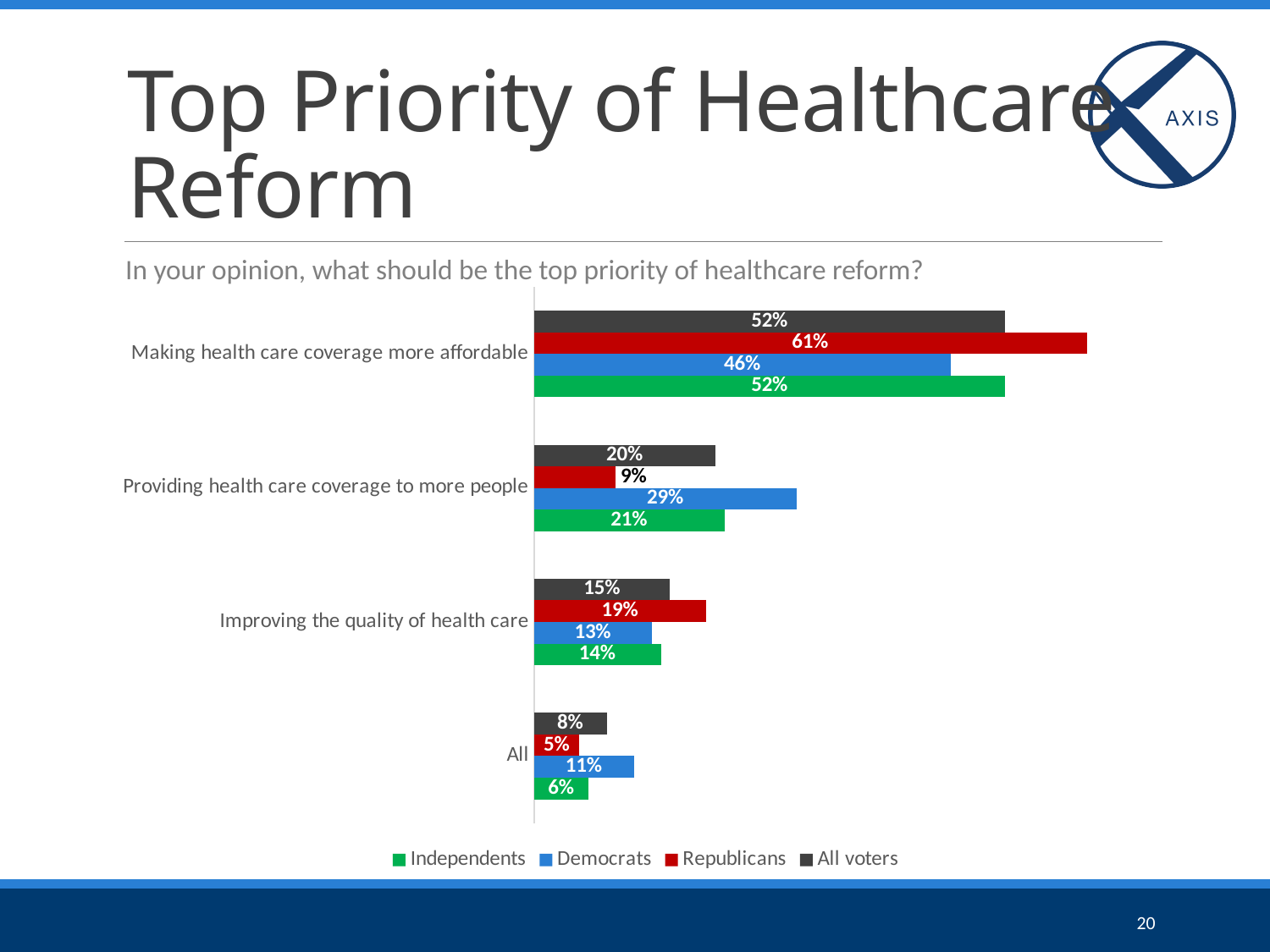
Which group has the lowest value for "Providing health care coverage to more people"? Republicans For "Improving the quality of health care", which is larger: the Republicans value or the Democrats value? Republicans How many priority categories are shown on the chart? 4 What kind of chart is shown on the slide? Bar chart How many series does the legend list? 4 What is the value for Independents for "Improving the quality of health care"? 14% Which group has the highest value for "Making health care coverage more affordable"? Republicans What is the value for Democrats for "Providing health care coverage to more people"? 29% What is the difference between the Republicans and Democrats values for "Making health care coverage more affordable"? 15% What percentage of Republicans chose "Making health care coverage more affordable" as the top priority? 61% Which colour represents Independents in the legend? Green What is the value for All voters for the "All" category? 8%